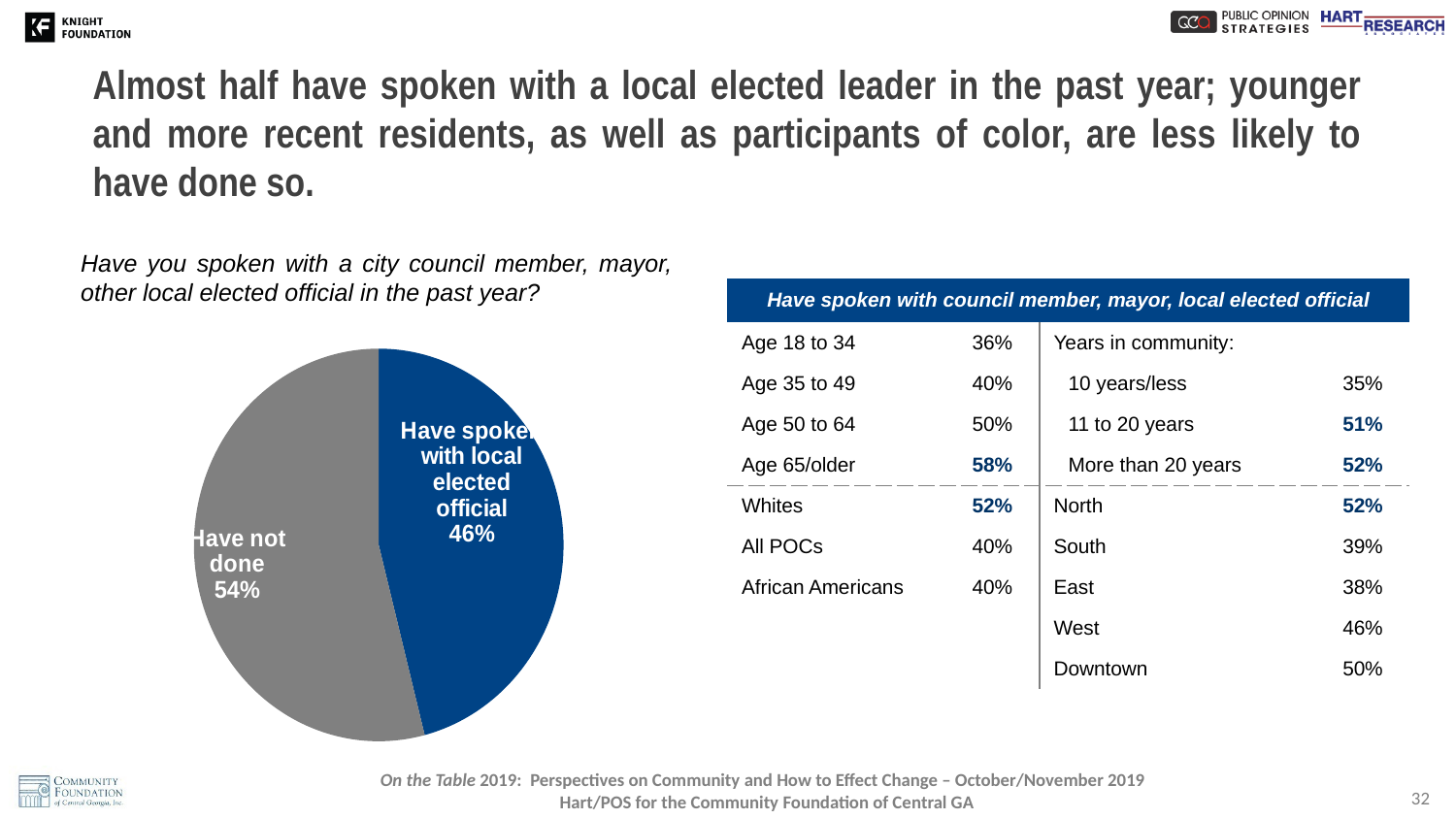
Which slice of the pie chart is the largest? Have not done What share of the pie does the 'Have spoken with local elected official' slice represent? 46% How many slices does the pie chart have? 2 What colour is the 'Have spoken with local elected official' slice in the pie chart? blue In the pie chart, which is larger: 'Have spoken with local elected official' or 'Have not done'? Have not done What is the difference in percentage points between the 'Have not done' slice and the 'Have spoken with local elected official' slice? 8 What colour is the 'Have not done' slice in the pie chart? gray Is the 'Have spoken with local elected official' slice greater or less than 50% of the pie? less What percentage of the pie chart is labeled 'Have not done'? 54% What percentage of the pie chart is labeled 'Have spoken with local elected official'? 46% Which slice of the pie chart is the smallest? Have spoken with local elected official What kind of chart is shown on the slide? pie chart